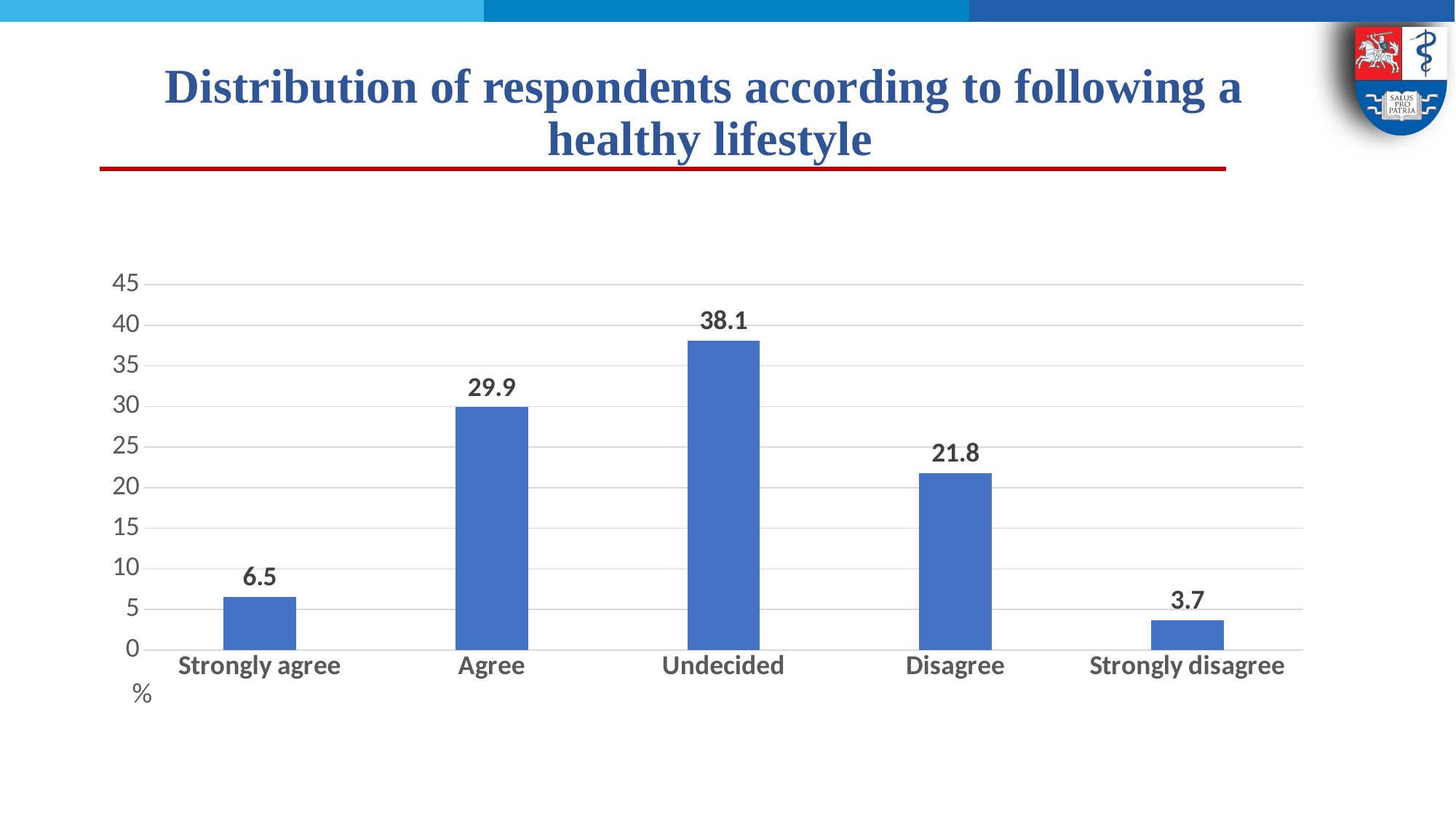
What is the difference between the values for Strongly agree and Strongly disagree? 2.8 Which is larger, the value for Agree or the value for Disagree? Agree Which category has the lowest value? Strongly disagree What is the value for Undecided? 38.1 How many categories are shown on the x axis? 5 Is the value for Disagree greater or less than 25? less Which category has the highest value? Undecided What kind of chart is shown on the slide? bar chart What is the title of the chart on the slide? Distribution of respondents according to following a healthy lifestyle What is the value for Disagree? 21.8 What is the value for Strongly agree? 6.5 What is the difference between the values for Undecided and Agree? 8.2